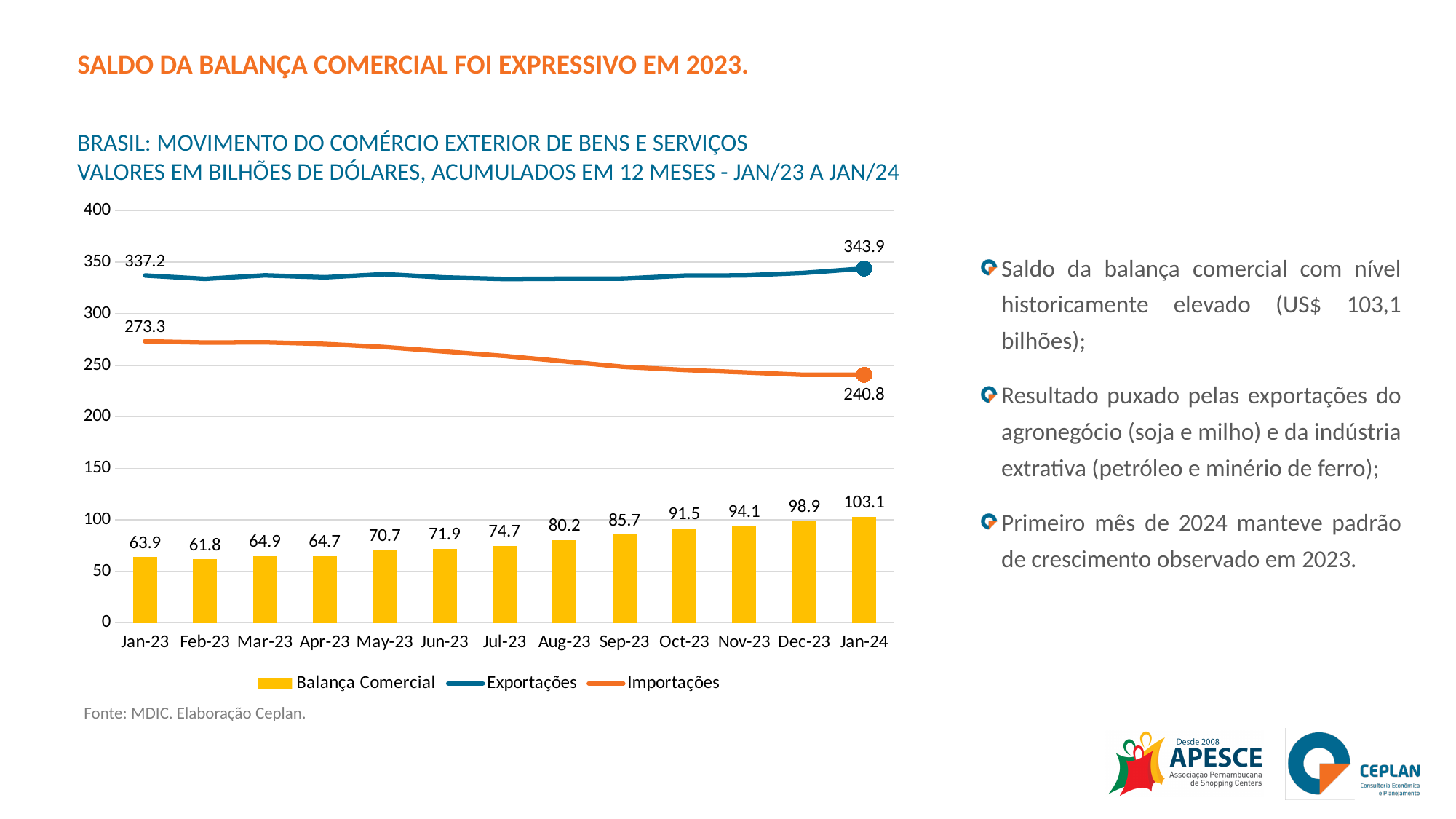
What is the difference between the Importações values for Jan-23 and Jan-24? 32.5 Which month has the highest Balança Comercial value? Jan-24 What is the value of Balança Comercial for Jan-24? 103.1 What is the value of Importações for Jan-24? 240.8 Is the value of Importações for Jul-23 greater or less than 250? greater How many months are shown on the x axis? 13 What is the value of Exportações for Jan-23? 337.2 Which is larger, the Balança Comercial value for Oct-23 or for Nov-23? Nov-23 How many series does the legend list? 3 What is the difference between the Balança Comercial values for Jan-24 and Jan-23? 39.2 Which month has the lowest Balança Comercial value? Feb-23 Does the Importações line rise or fall from Jan-23 to Jan-24? fall